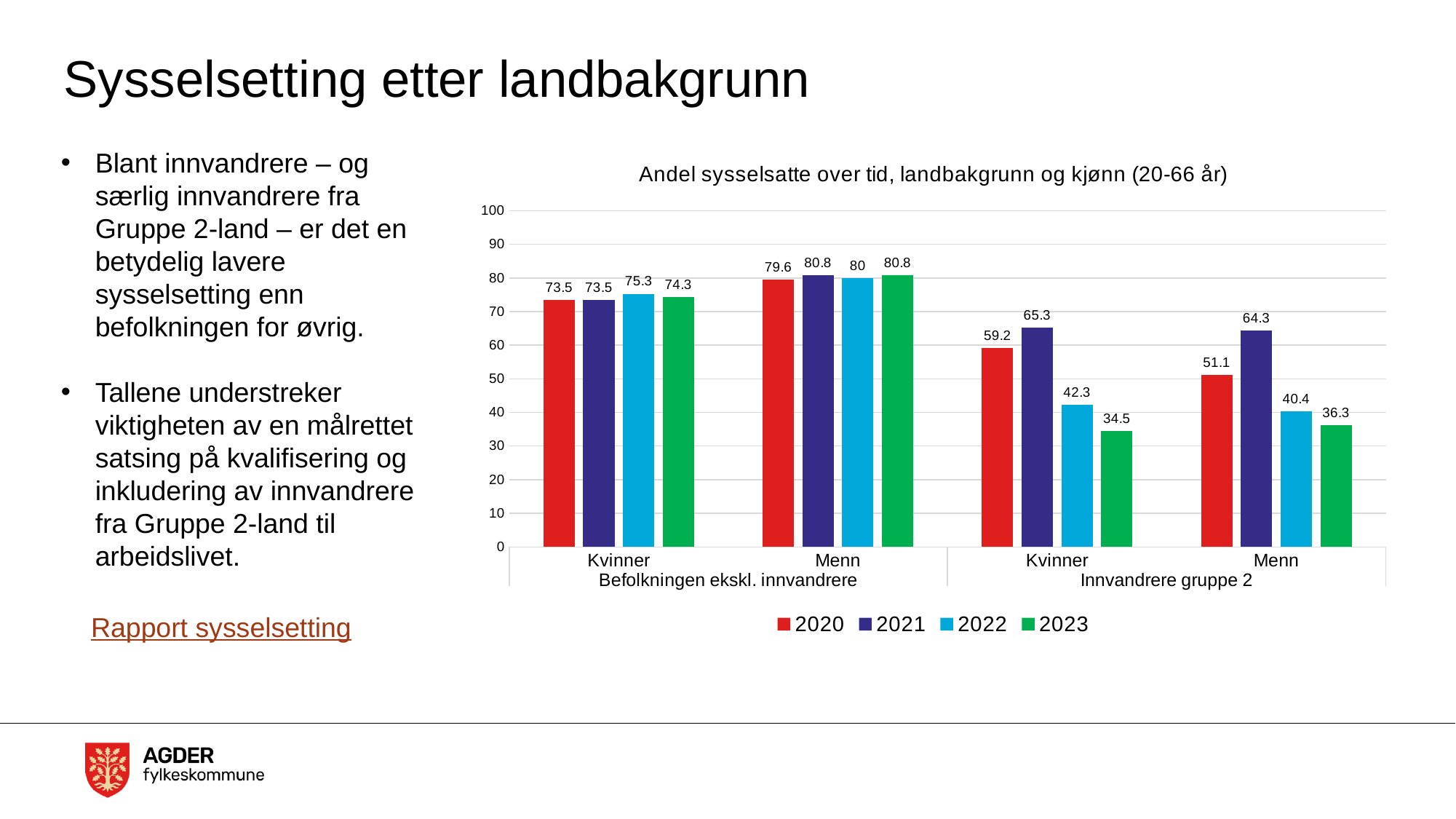
What is the difference between the 2021 and 2023 values for Kvinner in the Innvandrere gruppe 2 group? 30.8 Which is larger: the 2022 value for Kvinner in Befolkningen ekskl. innvandrere or the 2022 value for Kvinner in Innvandrere gruppe 2? Befolkningen ekskl. innvandrere What is the 2021 value for Menn in the Befolkningen ekskl. innvandrere group? 80.8 How many series does the legend list? 4 Do the values for Kvinner in the Innvandrere gruppe 2 group rise or fall from 2021 to 2023? fall Which year has the highest value for Kvinner in the Innvandrere gruppe 2 group? 2021 Is the 2022 value for Menn in the Innvandrere gruppe 2 group greater or less than 50? less What is the 2020 value for Menn in the Innvandrere gruppe 2 group? 51.1 What kind of chart is shown on the slide? bar chart Which year has the lowest value for Menn in the Innvandrere gruppe 2 group? 2023 What is the title of the chart? Andel sysselsatte over tid, landbakgrunn og kjønn (20-66 år) What is the 2023 value for Kvinner in the Innvandrere gruppe 2 group? 34.5